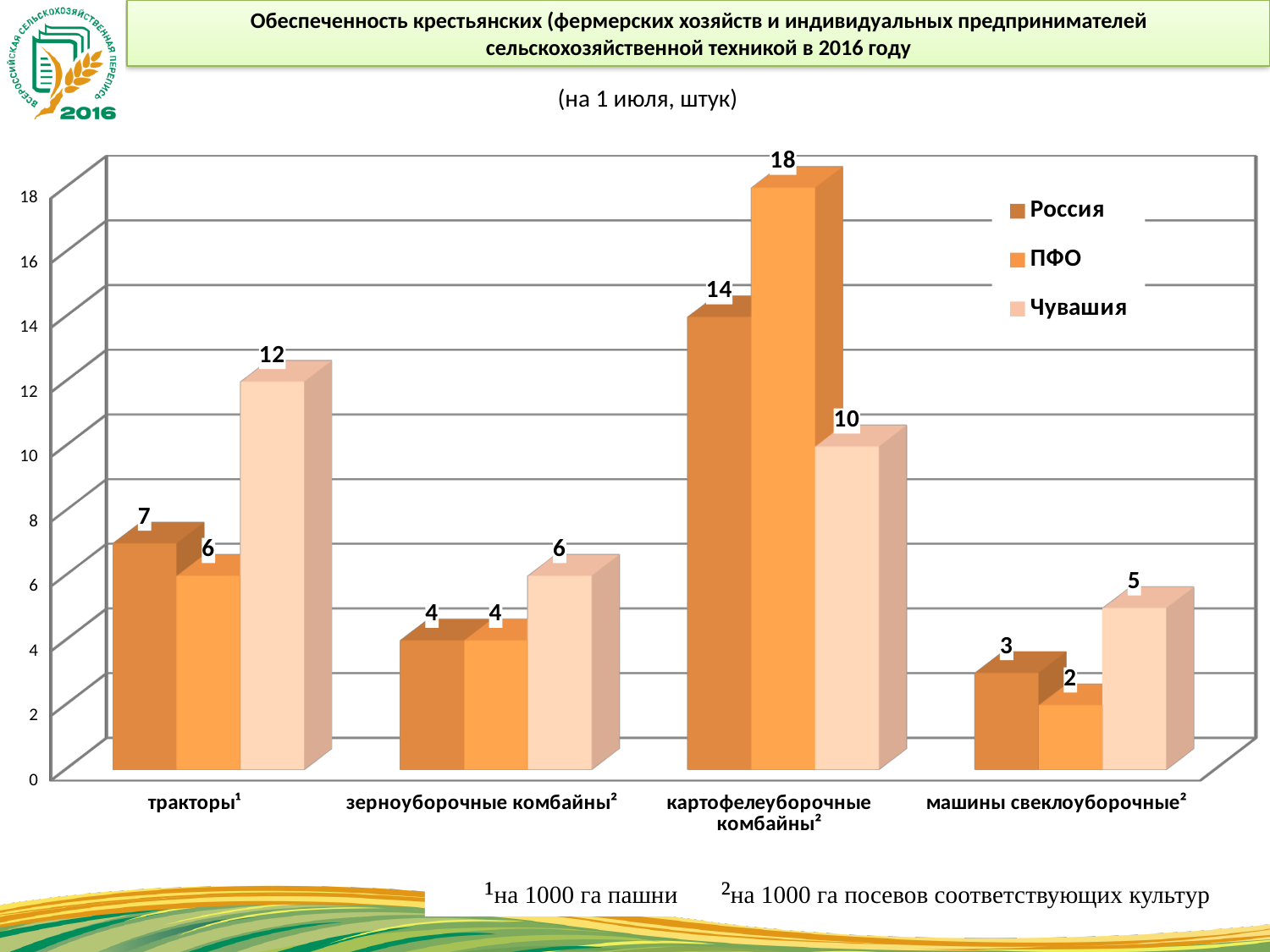
What is the value for Чувашия in the картофелеуборочные комбайны category? 10 Which category has the lowest value for Чувашия? машины свеклоуборочные Which series has the highest value in the картофелеуборочные комбайны category? ПФО How many series does the legend list? 3 What is the difference between the Чувашия and Россия values for тракторы? 5 Which series is shown in the lightest colour in the legend? Чувашия How many categories are shown on the x axis? 4 What is the value for Россия in the тракторы category? 7 What kind of chart is shown on the slide? bar chart Which is larger for зерноуборочные комбайны: the value for Чувашия or the value for ПФО? Чувашия What is the difference between the ПФО and Чувашия values for картофелеуборочные комбайны? 8 What is the value for ПФО in the машины свеклоуборочные category? 2